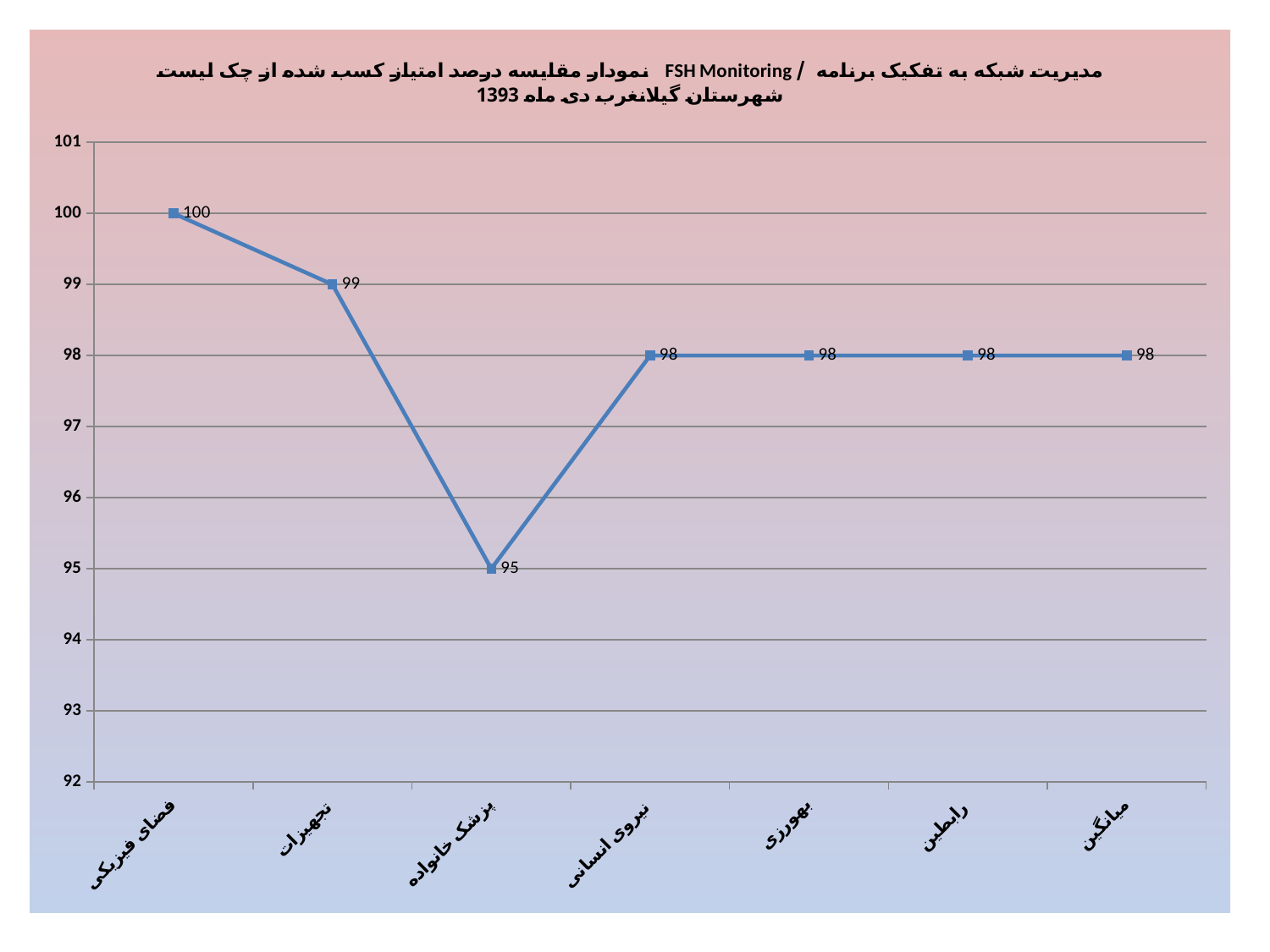
Is the value for پزشک خانواده greater or less than 97? less Which category has the highest value? فضای فیزیکی Which category has the lowest value? پزشک خانواده What is the value for تجهیزات? 99 What is the value for فضای فیزیکی? 100 Which is larger, the value for تجهیزات or the value for نیروی انسانی? تجهیزات What is the difference between the values for فضای فیزیکی and پزشک خانواده? 5 What is the lowest value shown on the y axis? 92 What is the value for پزشک خانواده? 95 What is the value for میانگین? 98 How many categories are plotted on the x axis? 7 What type of chart is shown on the slide? line chart